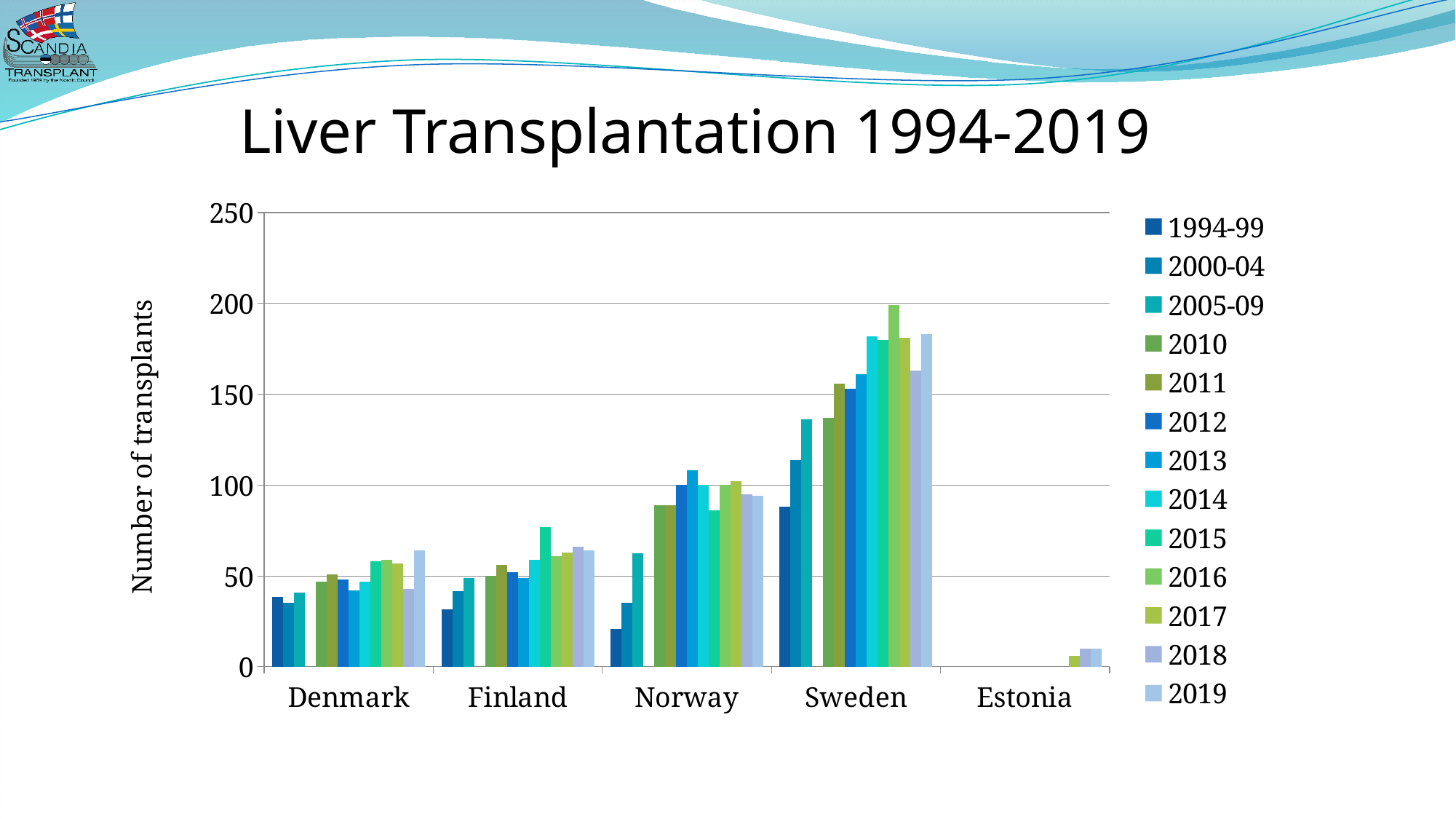
How many series does the legend list? 13 For Finland, which period has the highest bar? 2015 For Sweden, which period has the highest bar? 2016 Is the value for Sweden in 2016 greater or less than 150? greater Is the value for Estonia in 2019 greater or less than 50? less Which country has the lowest number of liver transplants overall? Estonia Is the value for Denmark in 1994-99 greater or less than 50? less Which is larger: the value for Sweden in 2019 or the value for Norway in 2019? Sweden in 2019 What is the label of the vertical axis? Number of transplants Which country has the highest number of liver transplants overall? Sweden What kind of chart is shown on the slide? bar chart How many countries are shown on the x axis of the chart? 5